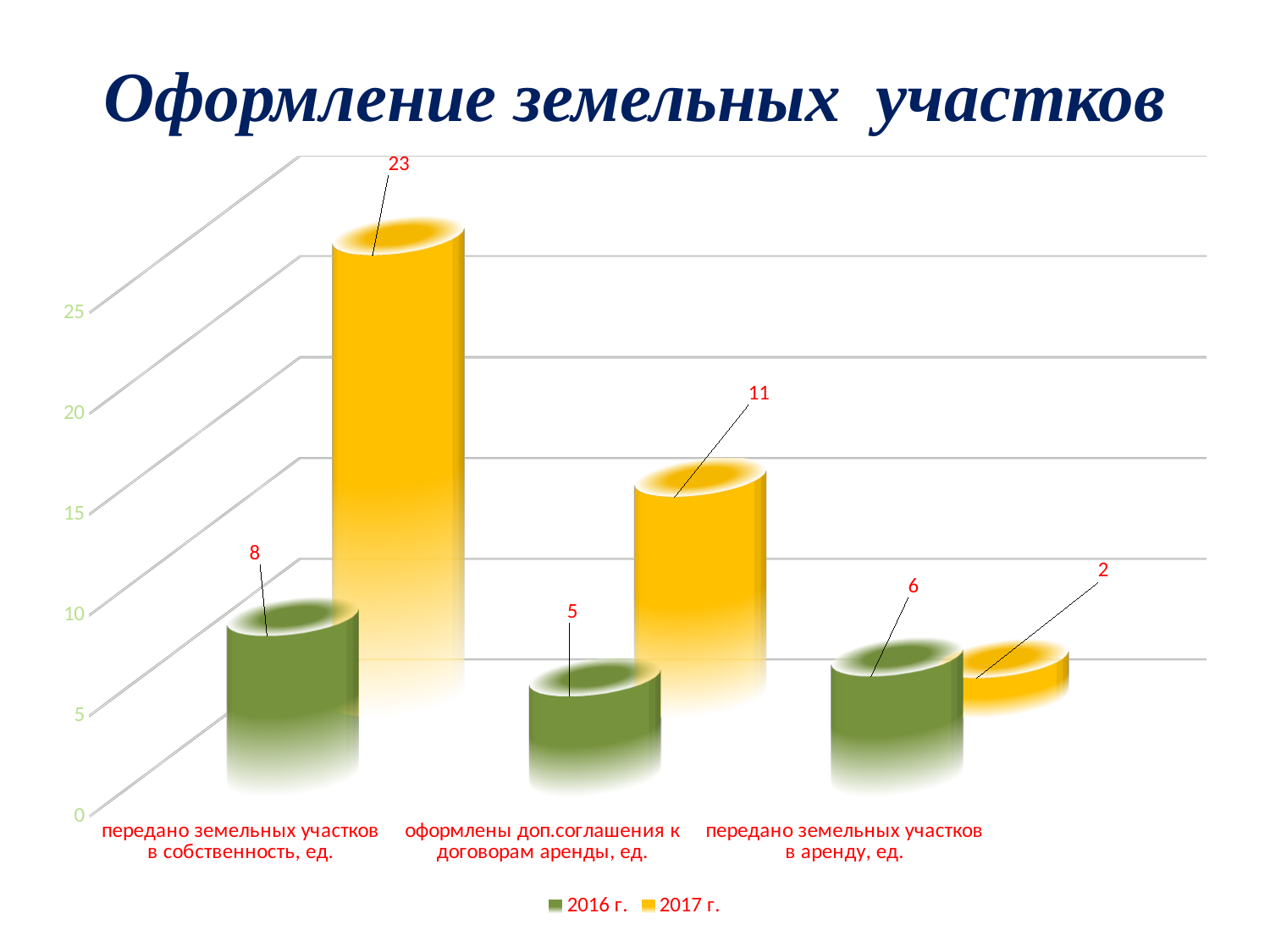
What is the value for 2016 г. in the category "оформлены доп.соглашения к договорам аренды, ед."? 5 Which category has the lowest value for the 2016 г. series? оформлены доп.соглашения к договорам аренды, ед. What is the value for 2017 г. in the category "передано земельных участков в аренду, ед."? 2 What is the value for 2017 г. in the category "передано земельных участков в собственность, ед."? 23 Which is larger for "передано земельных участков в аренду, ед.": the 2016 г. value or the 2017 г. value? 2016 г. How many categories are shown on the x axis? 3 What kind of chart is shown on the slide? bar chart What is the difference between the 2017 г. and 2016 г. values for "передано земельных участков в собственность, ед."? 15 Which category has the highest value for the 2017 г. series? передано земельных участков в собственность, ед. What is the value for 2016 г. in the category "передано земельных участков в аренду, ед."? 6 What is the title of the chart? Оформление земельных участков How many series does the legend list? 2